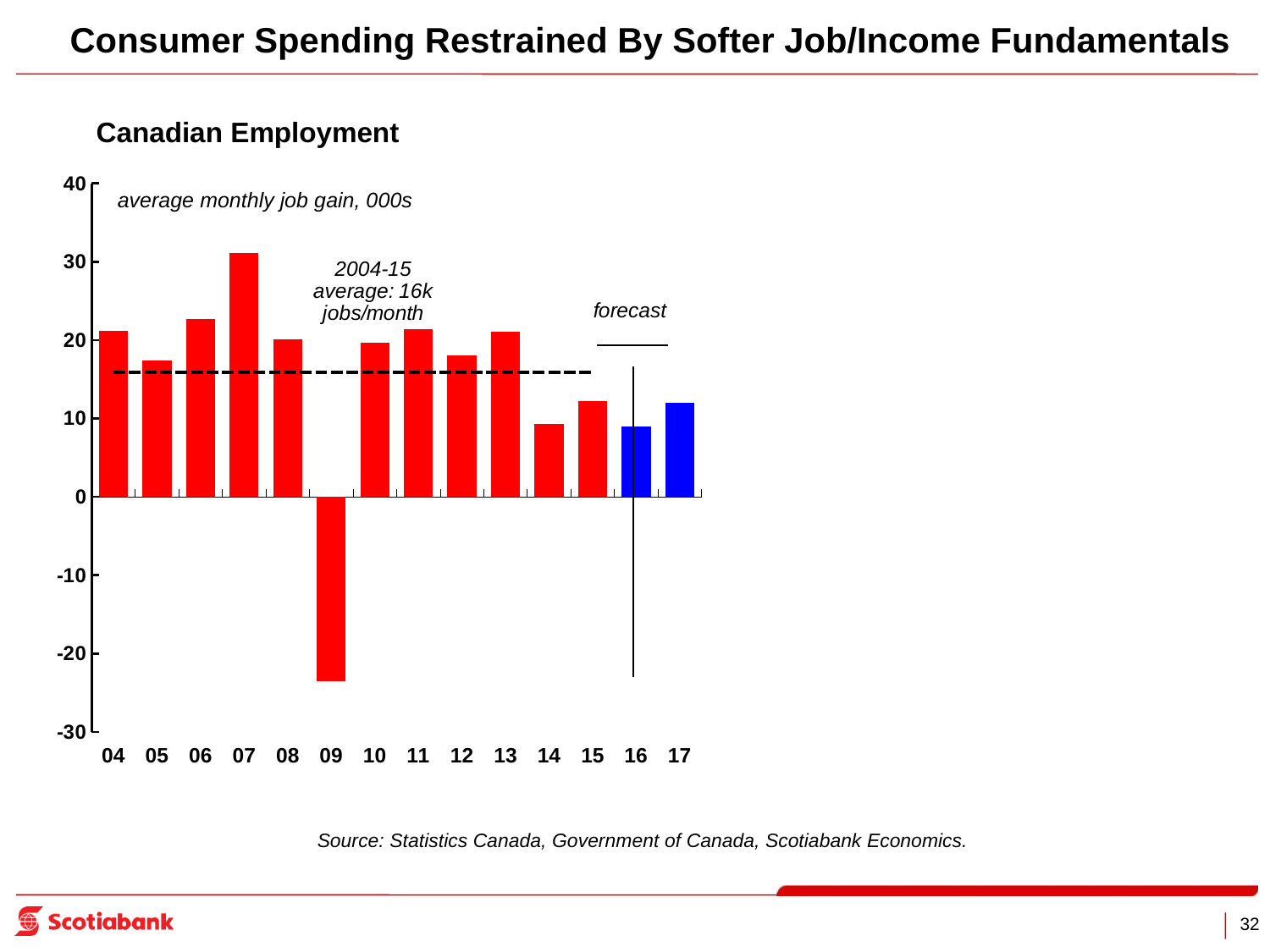
Which year has the highest average monthly job gain? 07 Is the value for 07 greater or less than 30? greater Is the value for 09 greater or less than -20? less Which years are shown as forecast values (blue bars)? 16 and 17 What kind of chart is shown on the slide? bar chart How many years are plotted on the x axis of the Canadian Employment chart? 14 Is the value for 06 greater or less than 20? greater Which year has the lowest average monthly job gain? 09 Which year has the larger average monthly job gain, 14 or 13? 13 What is the 2004-15 average monthly job gain stated on the chart? 16k jobs/month Which year has the larger average monthly job gain, 07 or 15? 07